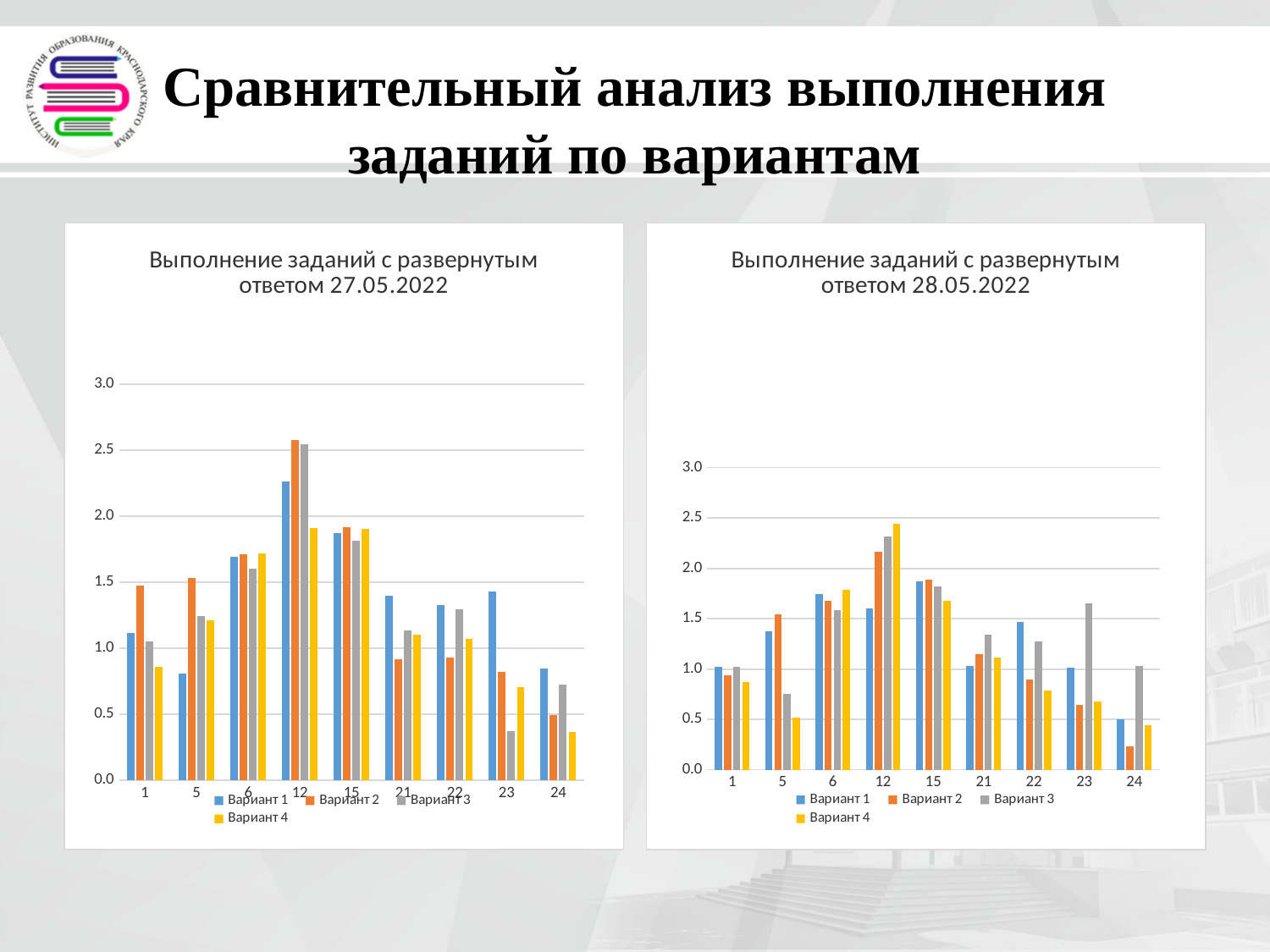
In the right chart (28.05.2022), which category has the lowest value for Вариант 2? 24 In the left chart (27.05.2022), at category 5, which is larger: Вариант 1 or Вариант 2? Вариант 2 In the right chart (28.05.2022), which category has the highest value for Вариант 4? 12 In the left chart (27.05.2022), is the value for Вариант 3 at category 23 greater or less than 0.5? less What is the title of the right chart? Выполнение заданий с развернутым ответом 28.05.2022 In the left chart (27.05.2022), which category has the highest value for Вариант 2? 12 How many categories are shown on the x axis of the left chart (27.05.2022)? 9 In the right chart (28.05.2022), at category 23, which is larger: Вариант 2 or Вариант 3? Вариант 3 In the right chart (28.05.2022), is the value for Вариант 3 at category 23 greater or less than 1.5? greater In the left chart (27.05.2022), is the value for Вариант 1 at category 12 greater or less than 2.0? greater What type of chart is the left chart titled "Выполнение заданий с развернутым ответом 27.05.2022"? bar chart How many series does the legend of the right chart (28.05.2022) list? 4